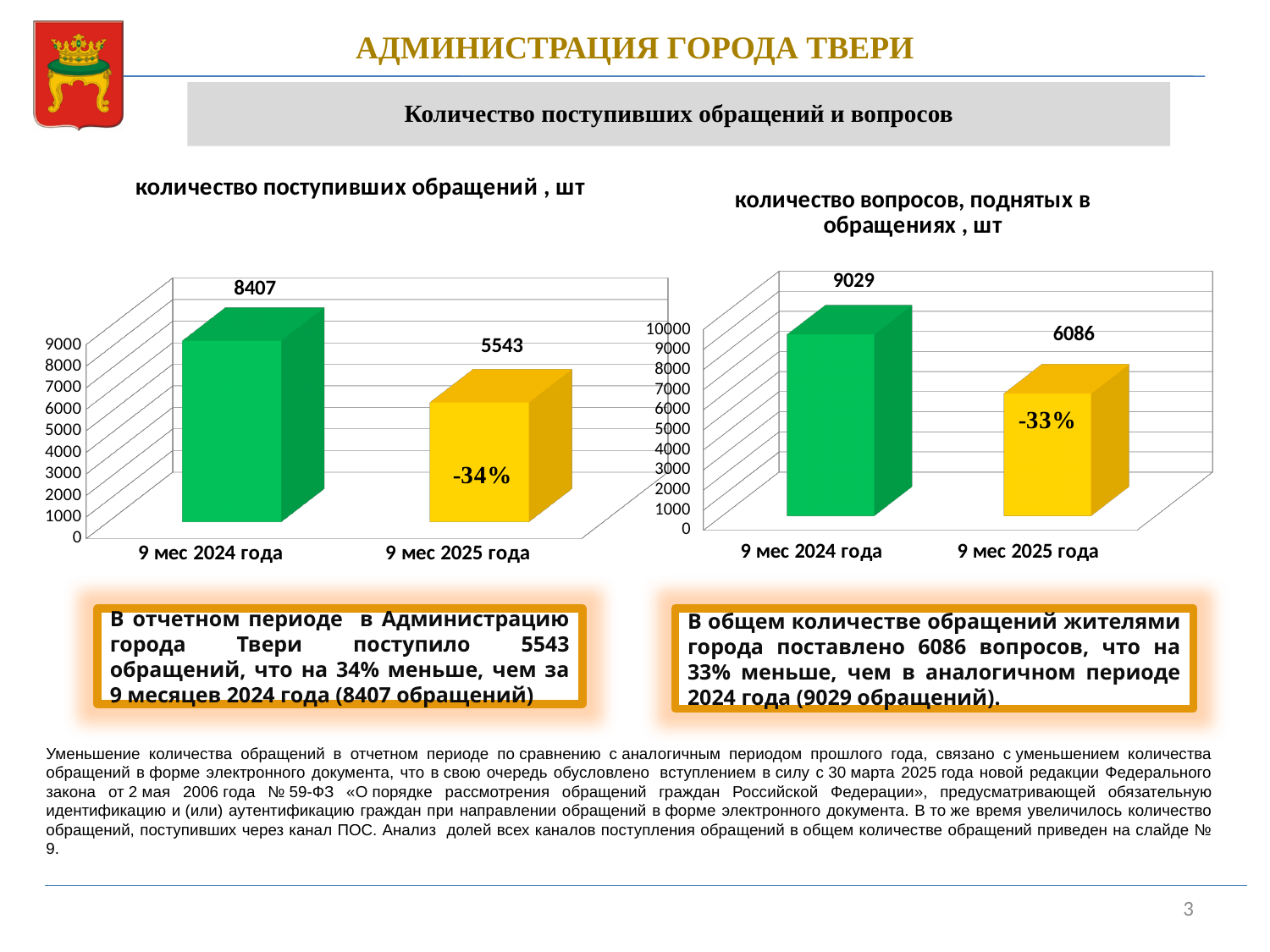
In the left chart 'количество поступивших обращений , шт', which period has the higher value? 9 мес 2024 года In the right chart 'количество вопросов, поднятых в обращениях , шт', what is the value for 9 мес 2025 года? 6086 In the right chart 'количество вопросов, поднятых в обращениях , шт', how many categories are shown on the x axis? 2 In the left chart 'количество поступивших обращений , шт', what is the difference between the 9 мес 2024 года and 9 мес 2025 года values? 2864 In the right chart 'количество вопросов, поднятых в обращениях , шт', what percentage change is labelled on the 9 мес 2025 года bar? -33% What type of chart is the left chart 'количество поступивших обращений , шт'? bar chart In the right chart 'количество вопросов, поднятых в обращениях , шт', which period has the lower value? 9 мес 2025 года In the right chart 'количество вопросов, поднятых в обращениях , шт', what is the value for 9 мес 2024 года? 9029 In the left chart 'количество поступивших обращений , шт', what percentage change is labelled on the 9 мес 2025 года bar? -34% In the left chart 'количество поступивших обращений , шт', what is the value for 9 мес 2024 года? 8407 In the left chart 'количество поступивших обращений , шт', what is the value for 9 мес 2025 года? 5543 In the right chart 'количество вопросов, поднятых в обращениях , шт', what is the difference between the 9 мес 2024 года and 9 мес 2025 года values? 2943